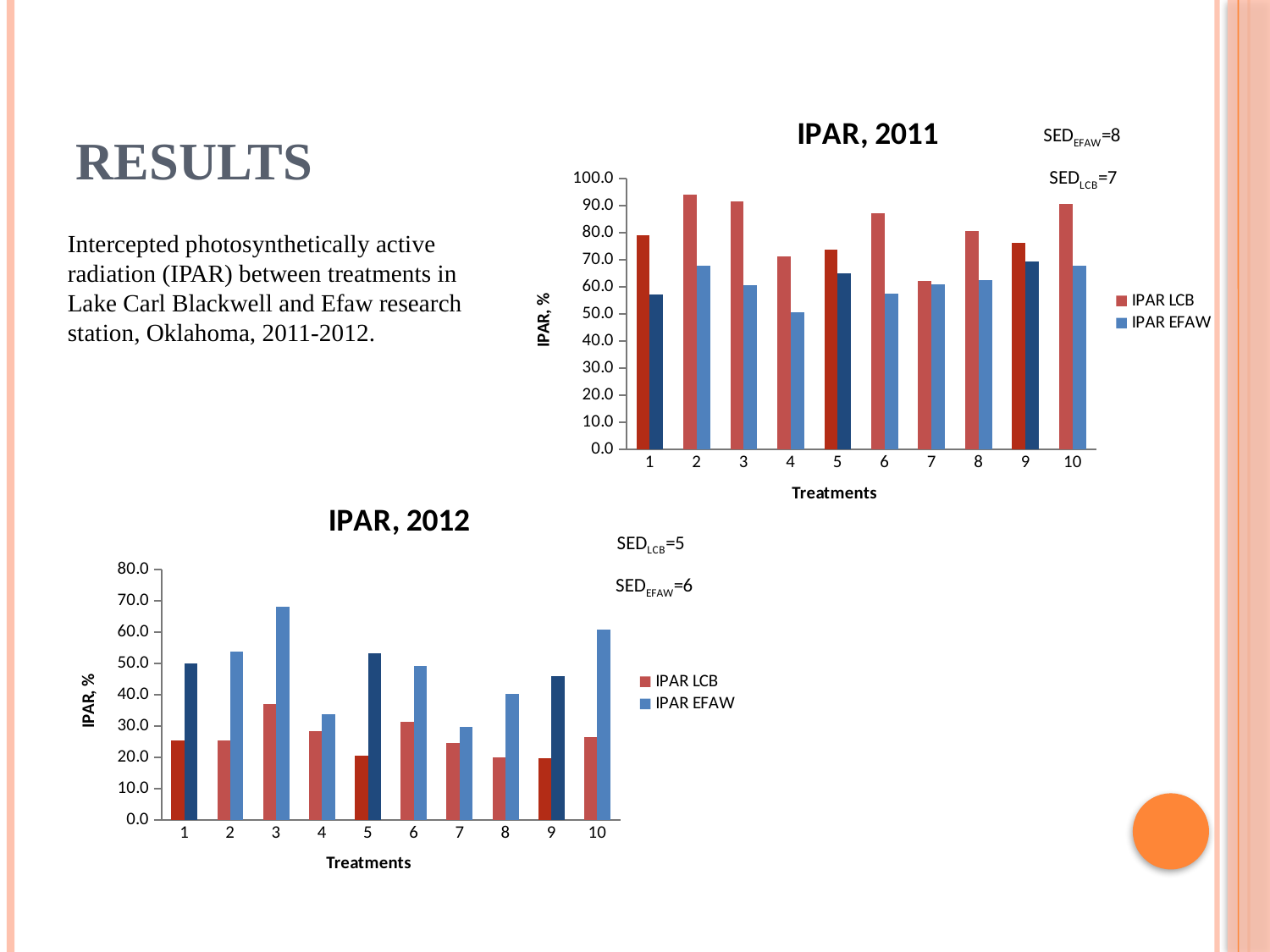
In the "IPAR, 2011" chart, how many series does the legend list? 2 In the "IPAR, 2012" chart, is the IPAR EFAW value for treatment 3 greater or less than 60.0? greater In the "IPAR, 2011" chart, is the IPAR LCB value for treatment 7 greater or less than 70.0? less In the "IPAR, 2012" chart, which treatment has the highest IPAR EFAW value? 3 In the "IPAR, 2011" chart, for treatment 4, which is larger: IPAR LCB or IPAR EFAW? IPAR LCB In the "IPAR, 2012" chart, for treatment 1, which is larger: IPAR LCB or IPAR EFAW? IPAR EFAW What is the x-axis label of the "IPAR, 2011" chart? Treatments What kind of chart is the "IPAR, 2011" chart? bar chart What is the y-axis label of the "IPAR, 2012" chart? IPAR, % In the "IPAR, 2012" chart, is the IPAR LCB value for treatment 5 greater or less than 30.0? less In the "IPAR, 2012" chart, how many treatments are shown on the x axis? 10 In the "IPAR, 2011" chart, which treatment has the lowest IPAR EFAW value? 4